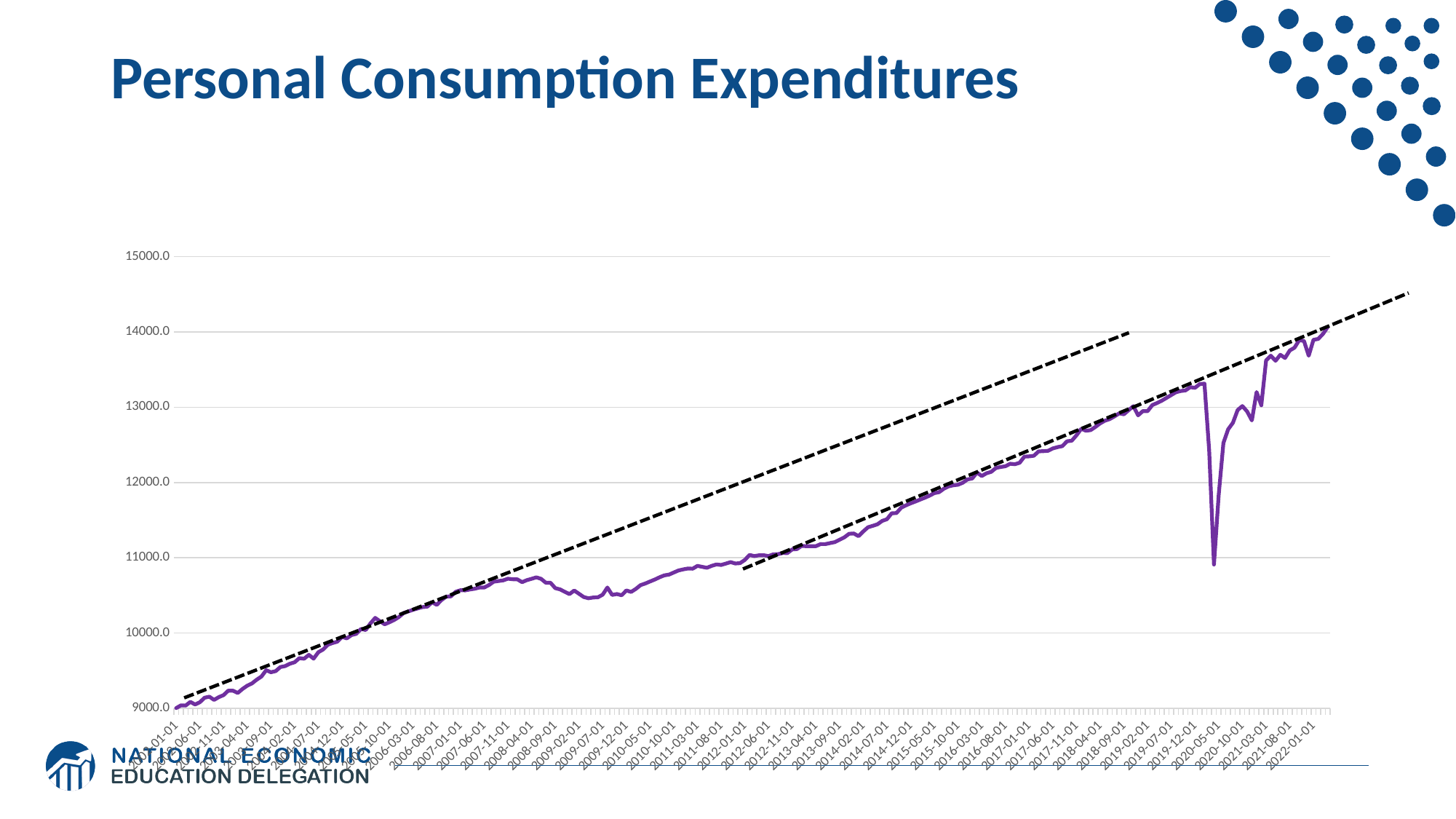
Overall, do the values rise or fall from left to right along the x axis? rise What kind of chart is shown on the slide? line chart Is the value at 2022-01-01 greater or less than 13000.0? greater Is the value at 2017-06-01 greater or less than 12000.0? greater Is the value at 2009-07-01 greater or less than 11000.0? less What is the highest tick value shown on the y axis? 15000.0 At which x-axis date does the line reach its lowest value? 2002-01-01 What is the title of the chart? Personal Consumption Expenditures Which is larger, the value at 2019-12-01 or the value at 2020-05-01? 2019-12-01